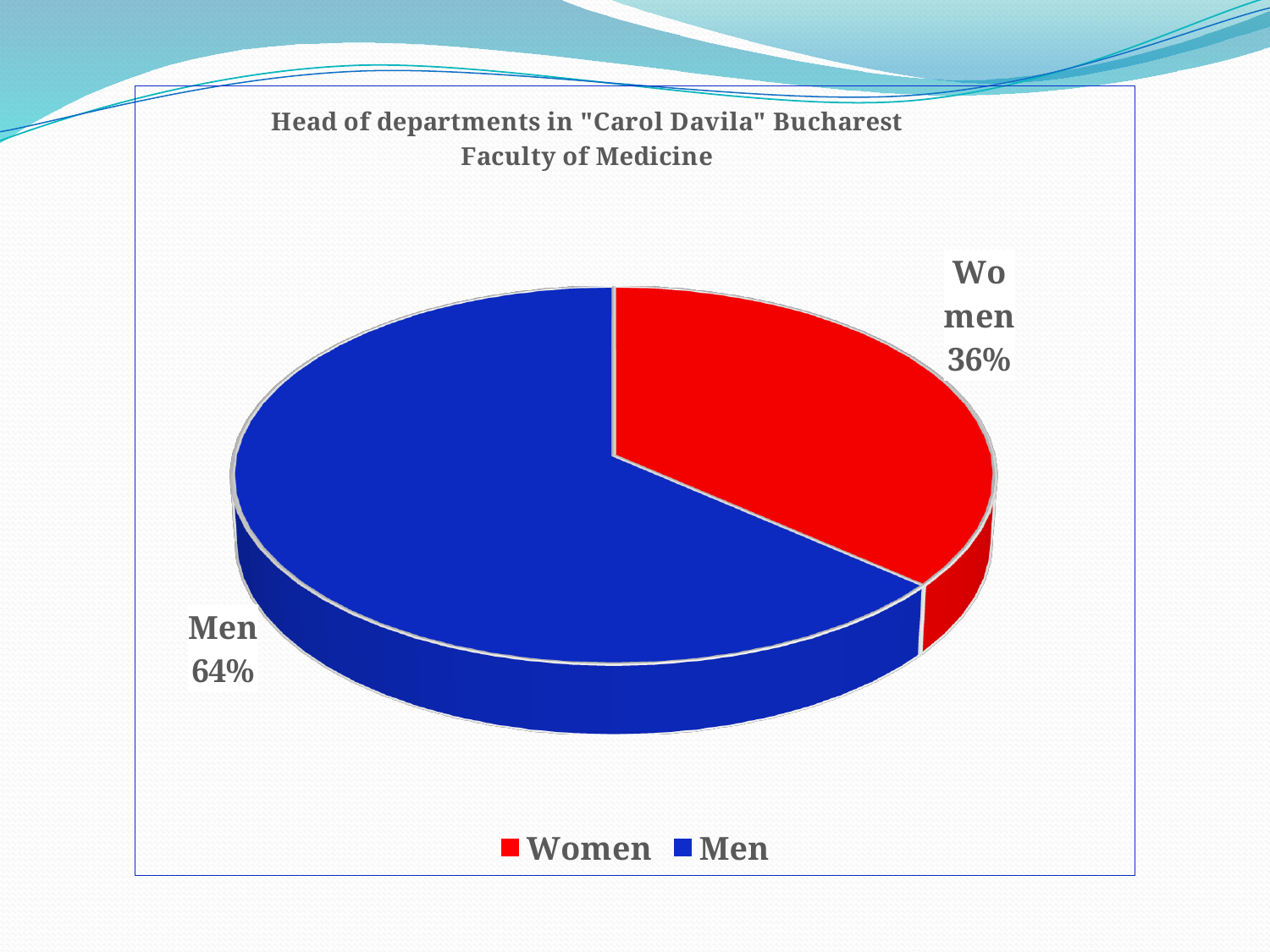
Which category has the smallest slice of the pie? Women What kind of chart is shown on the slide? Pie chart Which category has the largest slice of the pie? Men Is the share for Men greater or less than 50%? greater What share of heads of departments are men? 64% What is the difference in percentage points between the Men and Women slices? 28 What is the title of the chart? Head of departments in "Carol Davila" Bucharest Faculty of Medicine Which slice is larger, Women or Men? Men What colour is the Women slice? Red What share of heads of departments are women? 36% How many categories does the pie chart show? 2